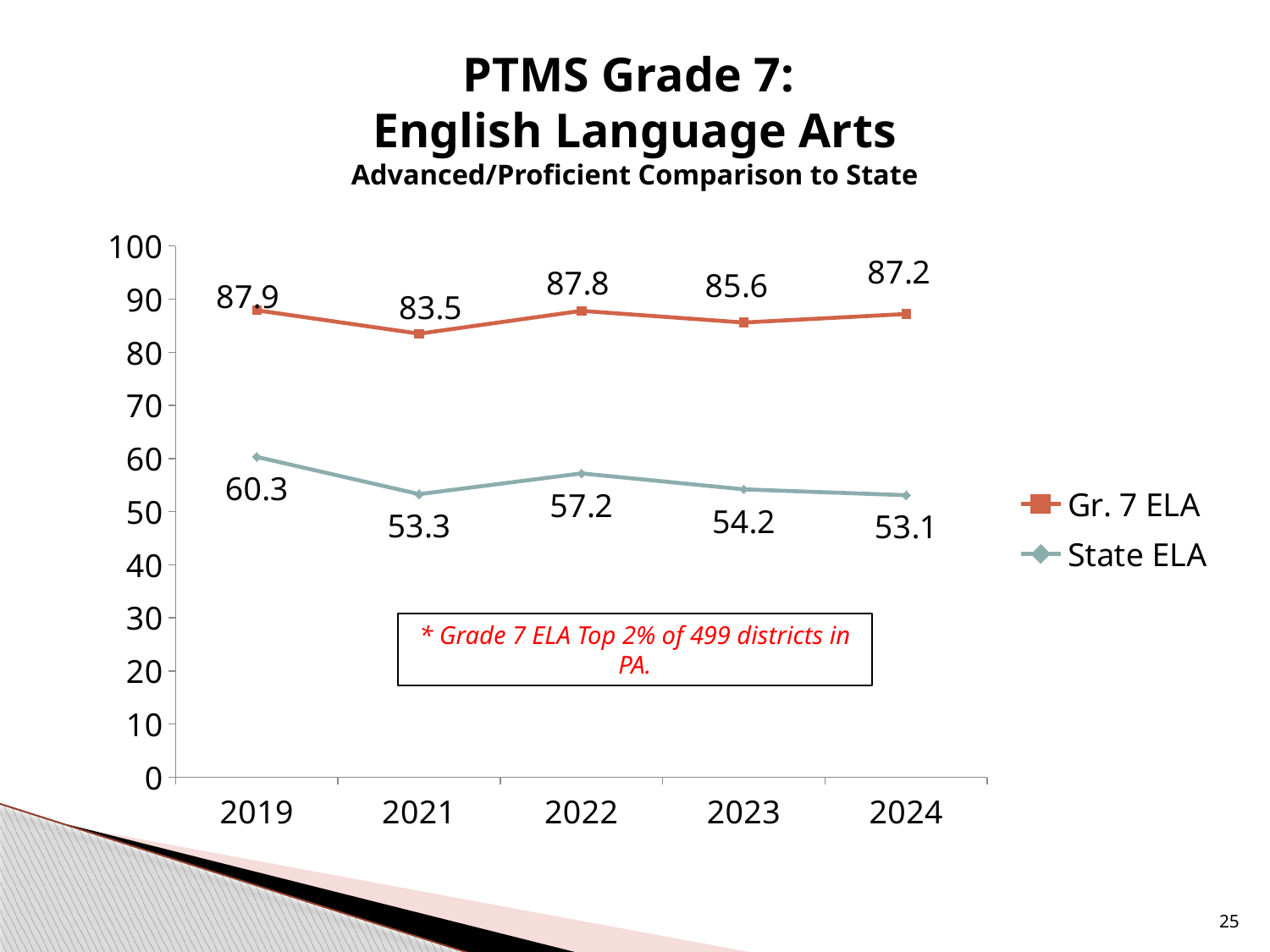
What is the difference between the Gr. 7 ELA and State ELA values in 2021? 30.2 In which year is the State ELA value lowest? 2024 What is the Gr. 7 ELA value for 2022? 87.8 What is the State ELA value for 2019? 60.3 Is the State ELA value for 2022 greater or less than 50? greater What is the State ELA value for 2024? 53.1 How many years are shown on the x axis? 5 Does the State ELA value rise or fall from 2022 to 2024? fall How many series does the legend list? 2 What kind of chart is shown on the slide? line chart Which is larger in 2023: the Gr. 7 ELA value or the State ELA value? Gr. 7 ELA In which year is the Gr. 7 ELA value highest? 2019